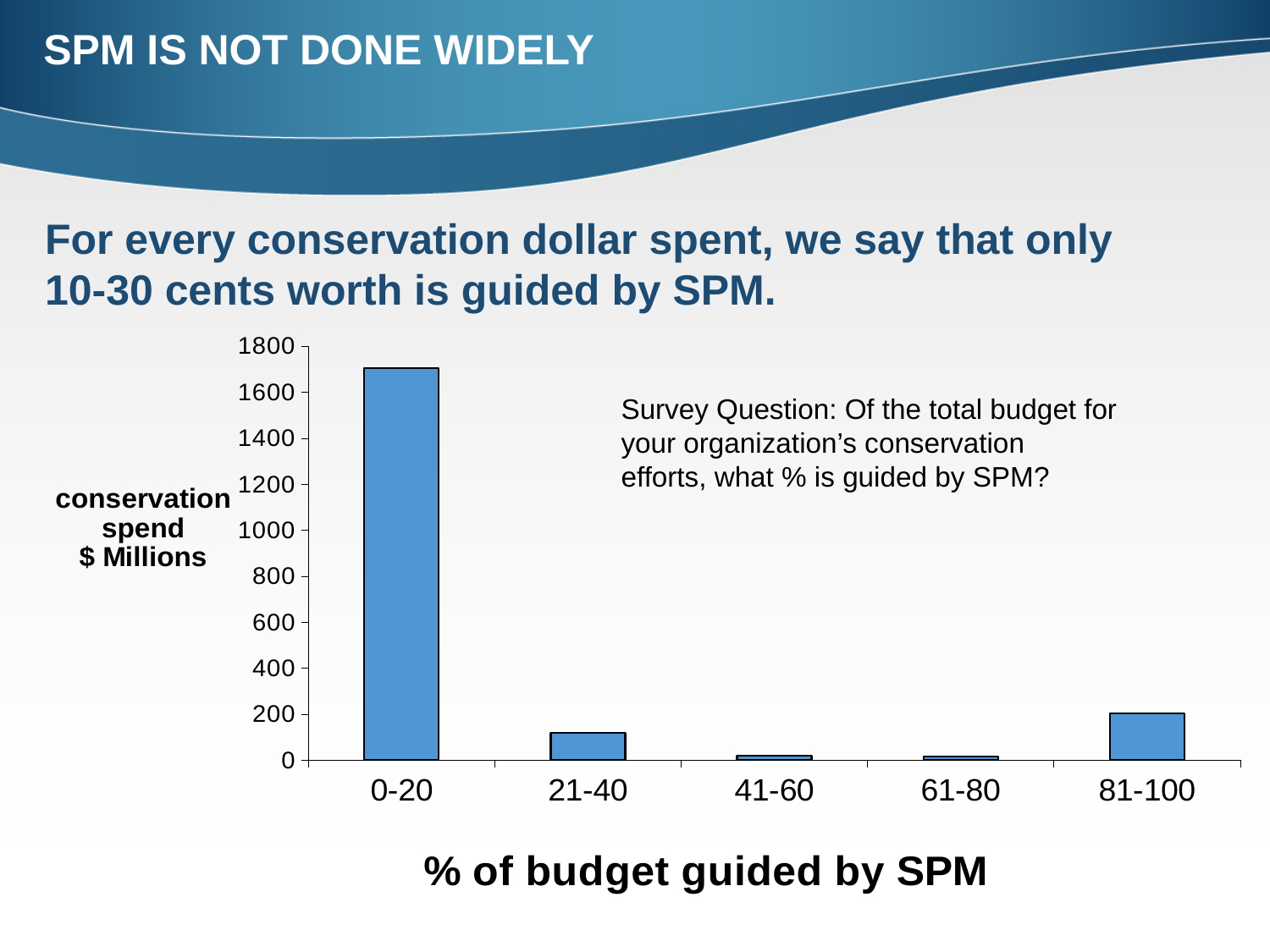
Which category has the highest conservation spend? 0-20 What kind of chart is shown on the slide? bar chart What is the title of the x axis of the chart? % of budget guided by SPM Is the value for the 41-60 category greater or less than 200? less Which has a larger conservation spend, the 21-40 category or the 81-100 category? 81-100 How many categories are shown on the x axis of the chart? 5 Is the value for the 0-20 category greater or less than 1600? greater Is the value for the 81-100 category greater or less than 100? greater Which has a larger conservation spend, the 0-20 category or the 81-100 category? 0-20 What is the label on the y axis of the chart? conservation spend $ Millions